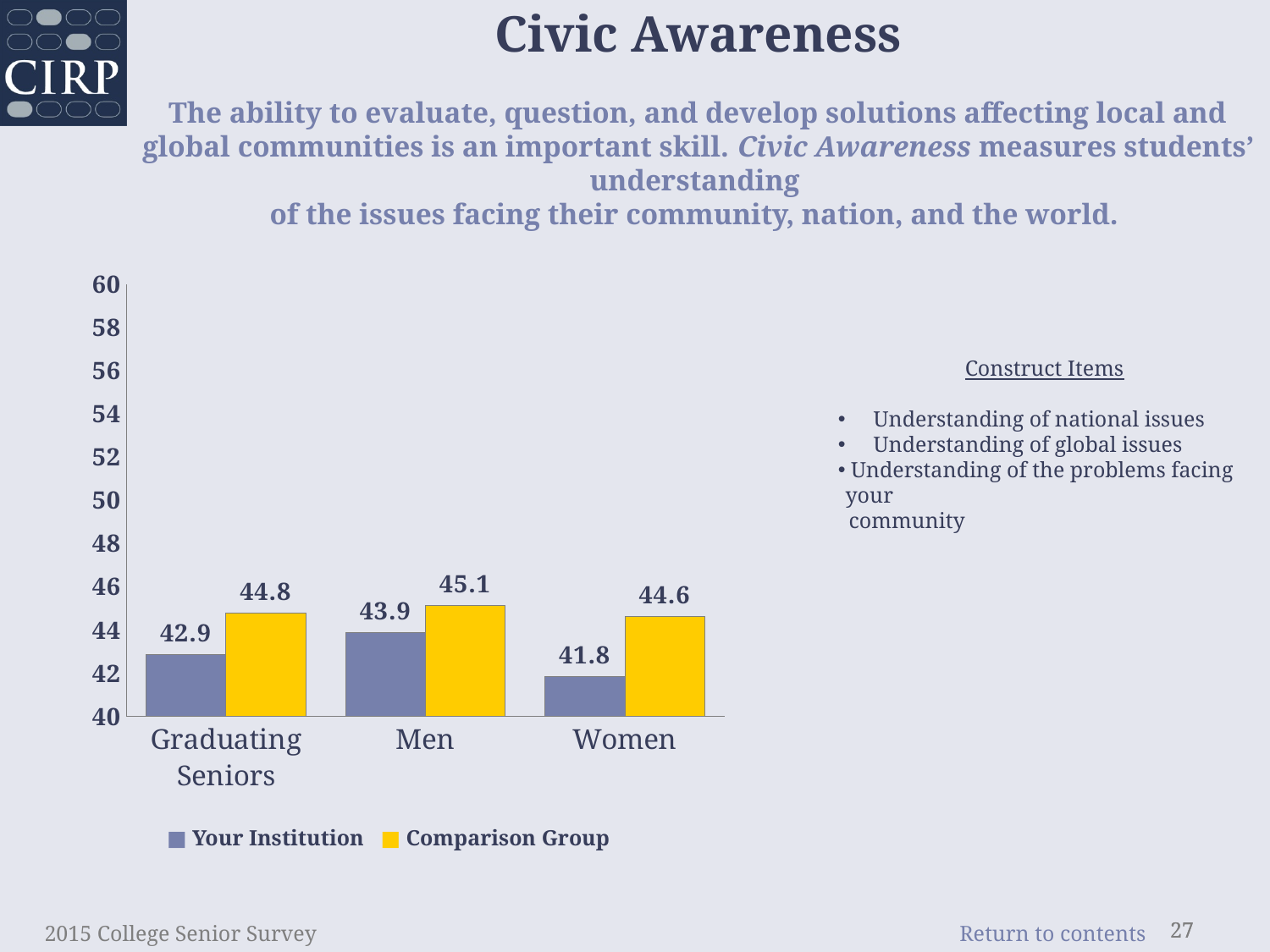
What is the difference between the Comparison Group and Your Institution values for Women? 2.8 What kind of chart is shown on the slide? Bar chart Which category has the highest Comparison Group value? Men What is the Comparison Group value for Women? 44.6 What is the Comparison Group value for Men? 45.1 How many categories are shown on the x axis? 3 Which colour represents the Comparison Group series? Yellow What is the Your Institution value for Graduating Seniors? 42.9 How many series does the legend list? 2 For Men, which is larger: Your Institution or Comparison Group? Comparison Group What is the Your Institution value for Women? 41.8 Which category has the lowest Your Institution value? Women